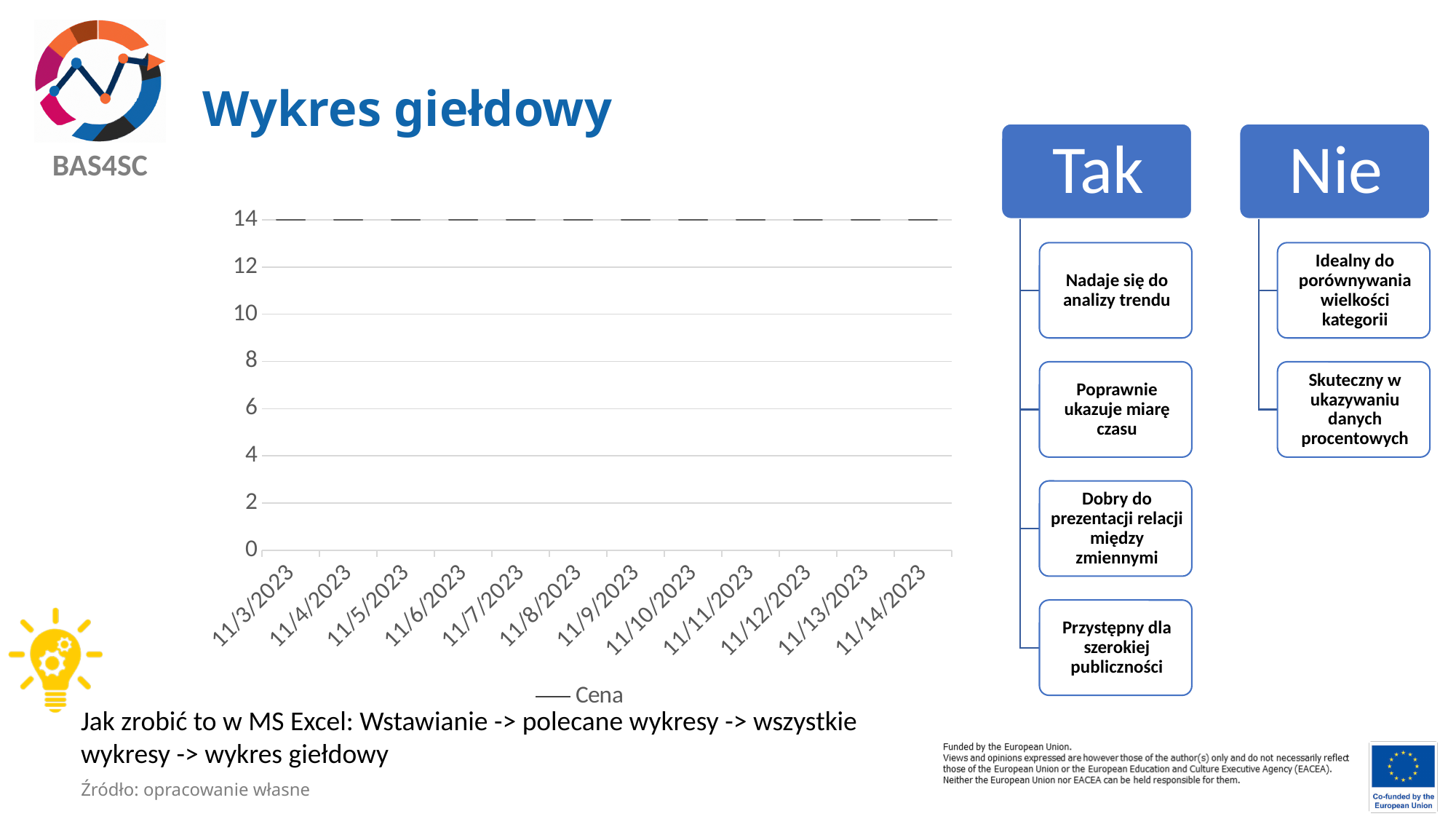
What is the last date shown on the x axis of the chart? 11/14/2023 What kind of chart is shown on the slide? stock chart What is the first date shown on the x axis of the chart? 11/3/2023 What is the lowest value shown on the y axis of the chart? 0 How many dates are shown on the x axis of the chart? 12 What is the name of the series shown in the chart legend? Cena What is the highest value shown on the y axis of the chart? 14 Is the value for 11/14/2023 greater or less than 8? greater Is the value for 11/3/2023 greater or less than 10? greater How many series does the chart legend list? 1